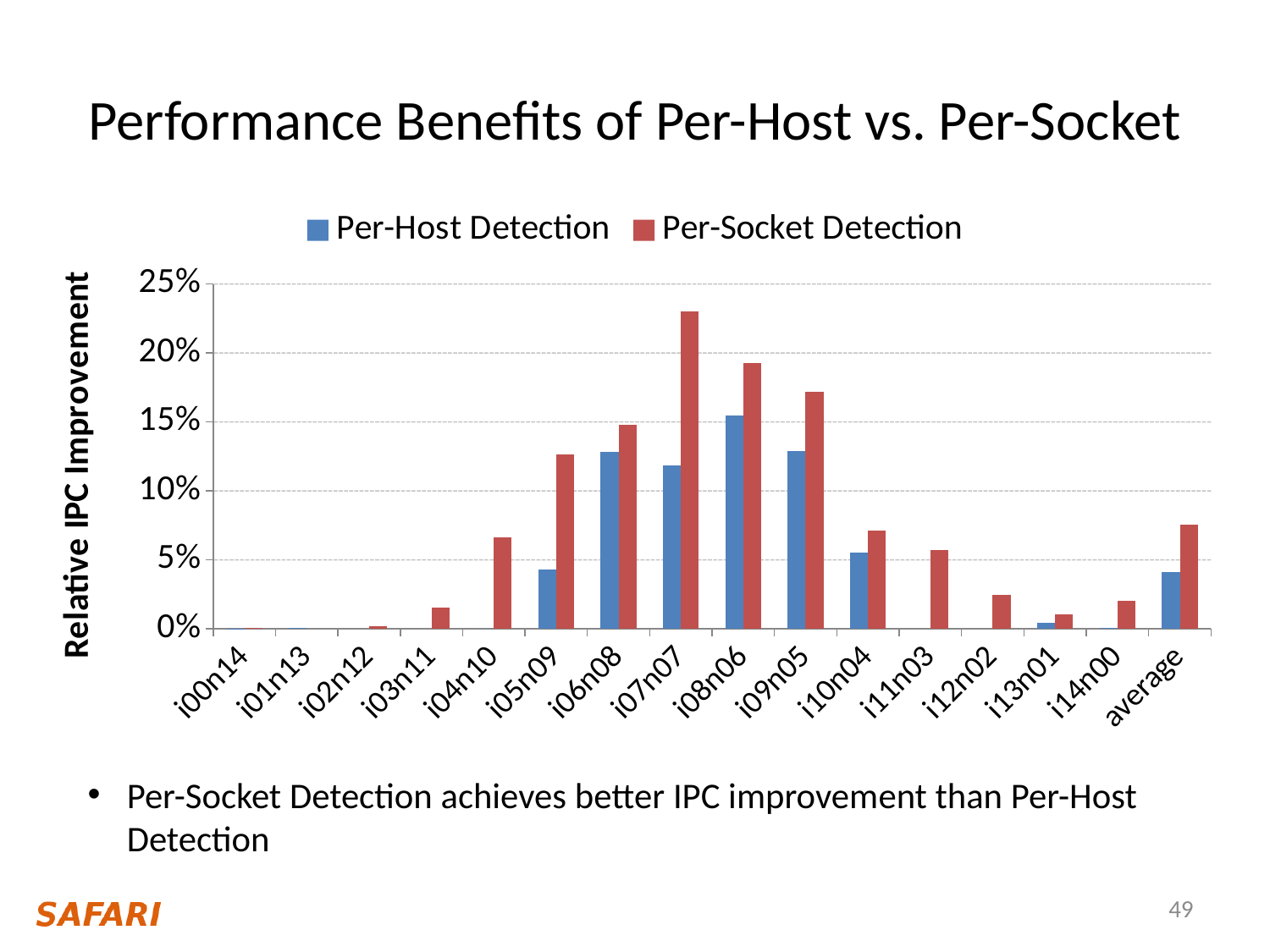
How many categories are shown on the x axis? 16 Is the Per-Socket Detection value for i07n07 greater or less than 20%? greater What kind of chart is shown on the slide? bar chart Is the Per-Host Detection value for i05n09 greater or less than 5%? less Is the Per-Socket Detection value for i12n02 greater or less than 5%? less Which category has the highest Per-Socket Detection value? i07n07 What is the label of the y axis? Relative IPC Improvement Which category has the highest Per-Host Detection value? i08n06 For i09n05, which is larger: Per-Host Detection or Per-Socket Detection? Per-Socket Detection How many series does the legend list? 2